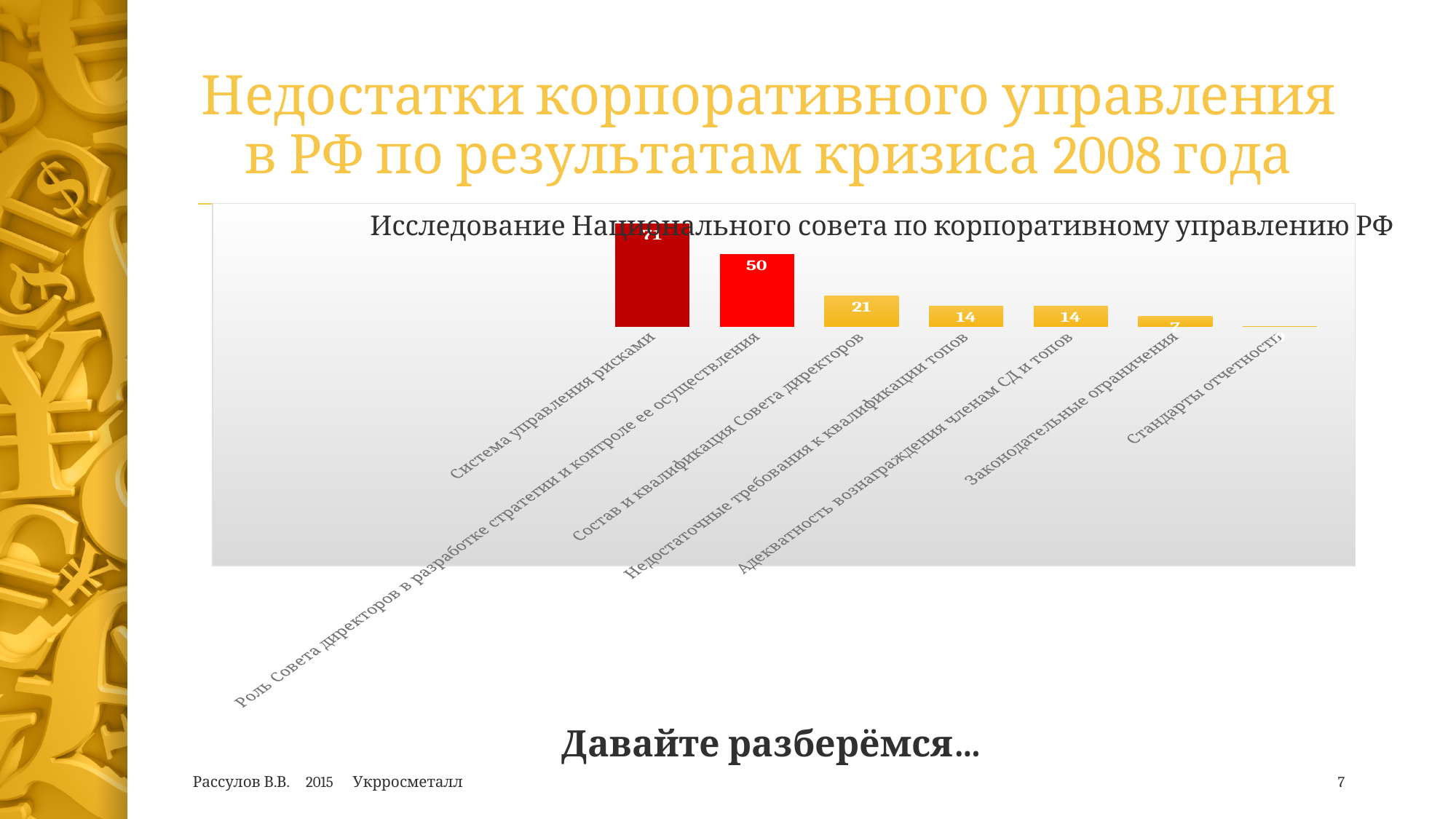
What is the value for Недостаточные требования к квалификации топов? 14 What is the value for Система управления рисками? 71 What is the value for Законодательные ограничения? 7 Do the values rise or fall from left to right along the x axis? Fall What is the difference between the values for Система управления рисками and Роль Совета директоров в разработке стратегии и контроле ее осуществления? 21 What type of chart is shown on the slide? Bar chart How many categories are shown in the chart? 7 What is the title of the chart? Исследование Национального совета по корпоративному управлению РФ What is the value for Состав и квалификация Совета директоров? 21 Which category has the highest value? Система управления рисками What is the value for Роль Совета директоров в разработке стратегии и контроле ее осуществления? 50 Which is larger: the value for Состав и квалификация Совета директоров or the value for Законодательные ограничения? Состав и квалификация Совета директоров